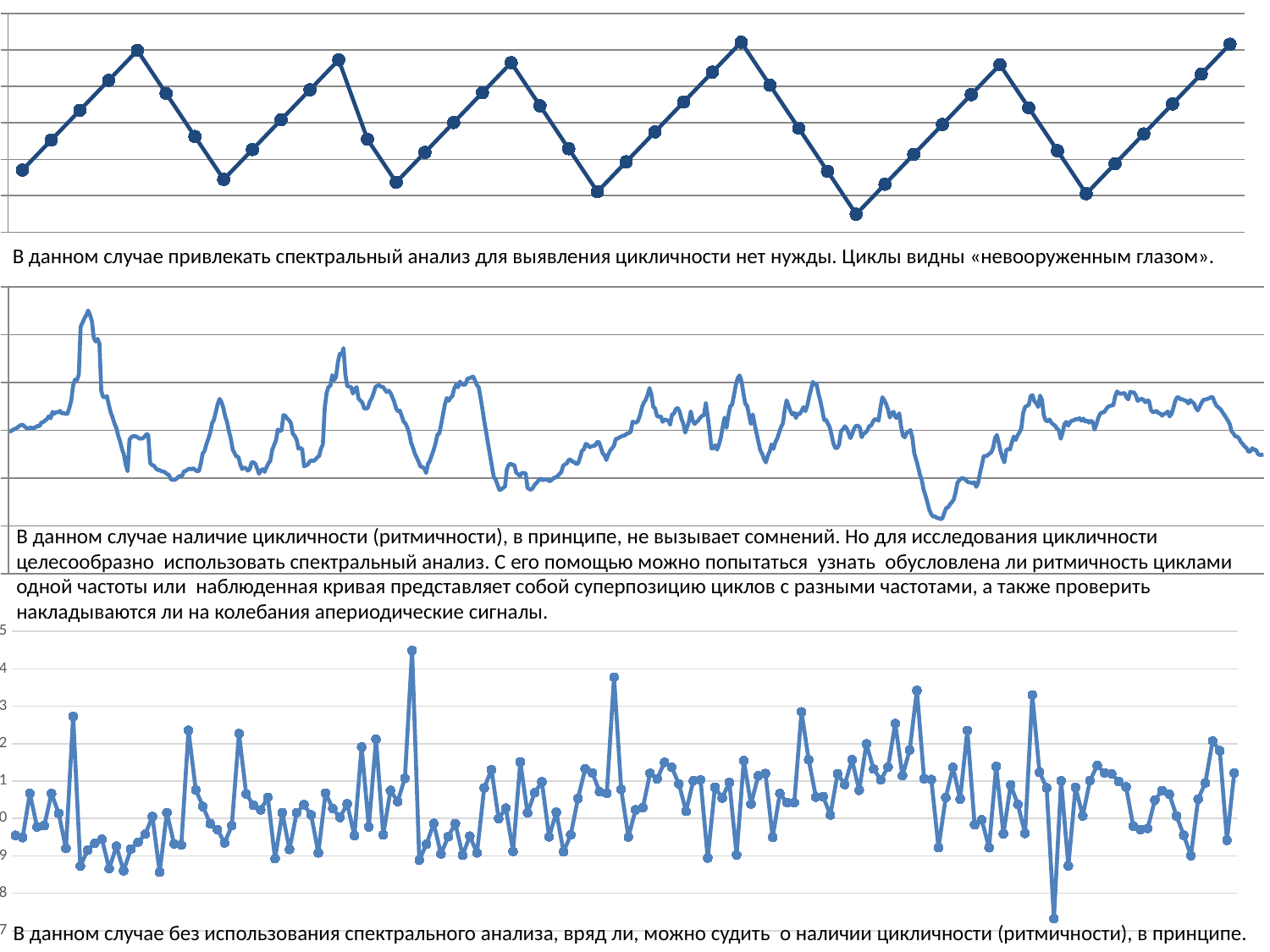
How many data series are plotted in the top chart? 1 How many charts are shown on the slide? 3 How many data series are plotted in the bottom chart? 1 In the bottom chart, is the lowest point located in the left half or the right half of the chart? right half What kind of chart is the top chart on the slide? line chart In the top chart, which of the troughs (low points) is the lowest: the first, second, third, fourth or fifth? the fourth What kind of chart is the middle chart on the slide? line chart Does the top chart show a steady upward trend, a steady downward trend, or a repeating up-and-down (cyclical) pattern? repeating up-and-down (cyclical) pattern In the middle chart, is the highest point located in the left half or the right half of the chart? left half In the bottom chart, is the highest point located in the left half or the right half of the chart? left half What kind of chart is the bottom chart on the slide? line chart